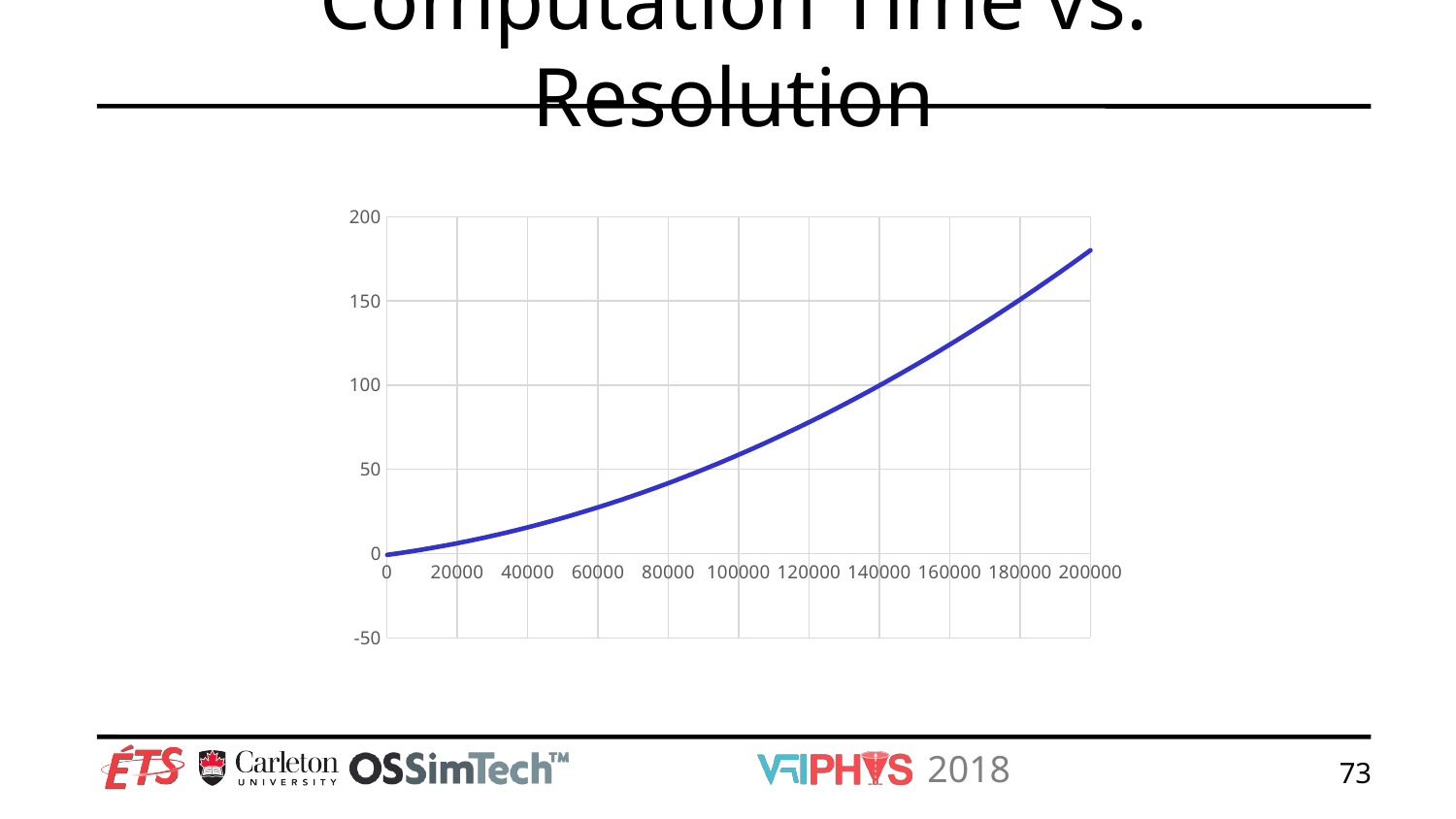
At which x value does the curve reach its highest point? 200000 At which x value does the curve have its lowest point? 0 Is the value at x = 120000 greater or less than 50? greater Is the value at x = 40000 greater or less than 50? less Is the value at x = 200000 greater or less than 150? greater Do the values rise or fall as the x axis increases from 0 to 200000? rise What is the title of the chart? Computation Time vs. Resolution What kind of chart is shown on the slide? line chart Which is larger, the value at x = 60000 or the value at x = 180000? 180000